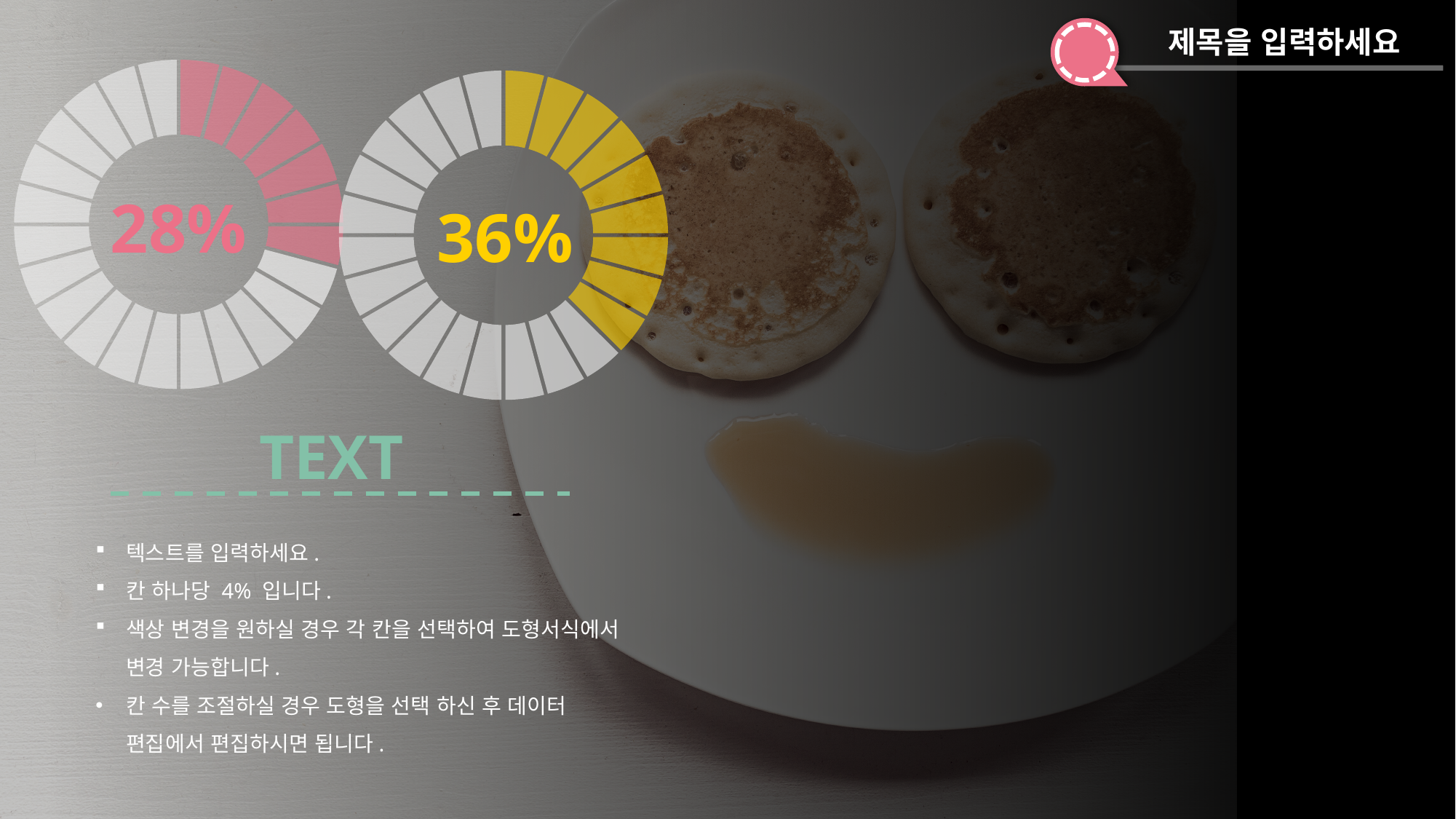
How many segments are filled with colour in the right donut chart? 9 Is the value shown in the right donut chart greater or less than 50%? less Is the value shown in the left donut chart greater or less than 50%? less What percentage is shown in the centre of the left donut chart? 28% According to the slide text, what percentage does each segment of the donut charts represent? 4% What percentage is shown in the centre of the right donut chart? 36% What colour are the filled segments in the right donut chart? Yellow What kind of chart is used to display the 28% and 36% values? Donut (ring) chart Which of the two donut charts shows the higher percentage, the left or the right? The right chart (36%) What is the difference between the percentage in the right donut chart and the percentage in the left donut chart? 8% How many segments are filled with colour in the left donut chart? 7 What colour are the filled segments in the left donut chart? Pink